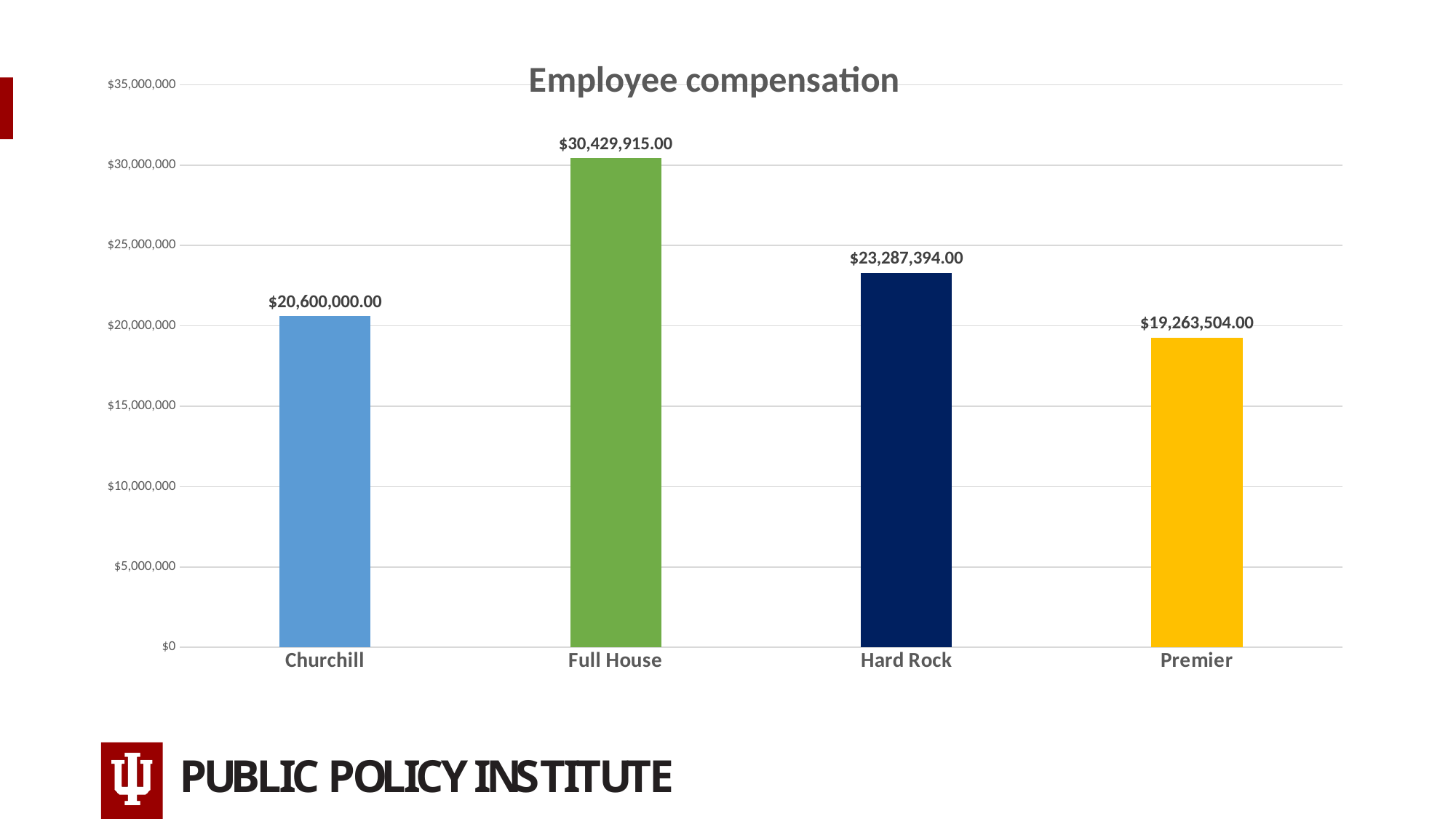
Which has higher employee compensation, Churchill or Hard Rock? Hard Rock What is the employee compensation value for Premier? $19,263,504.00 What kind of chart is shown on the slide? bar chart Which category has the highest employee compensation? Full House What is the employee compensation value for Full House? $30,429,915.00 What is the title of the chart? Employee compensation What is the difference in employee compensation between Full House and Churchill? $9,829,915.00 How many categories are shown in the chart? 4 What is the employee compensation value for Hard Rock? $23,287,394.00 What is the difference in employee compensation between Hard Rock and Premier? $4,023,890.00 Which category has the lowest employee compensation? Premier Is the employee compensation for Churchill greater or less than $25,000,000? less